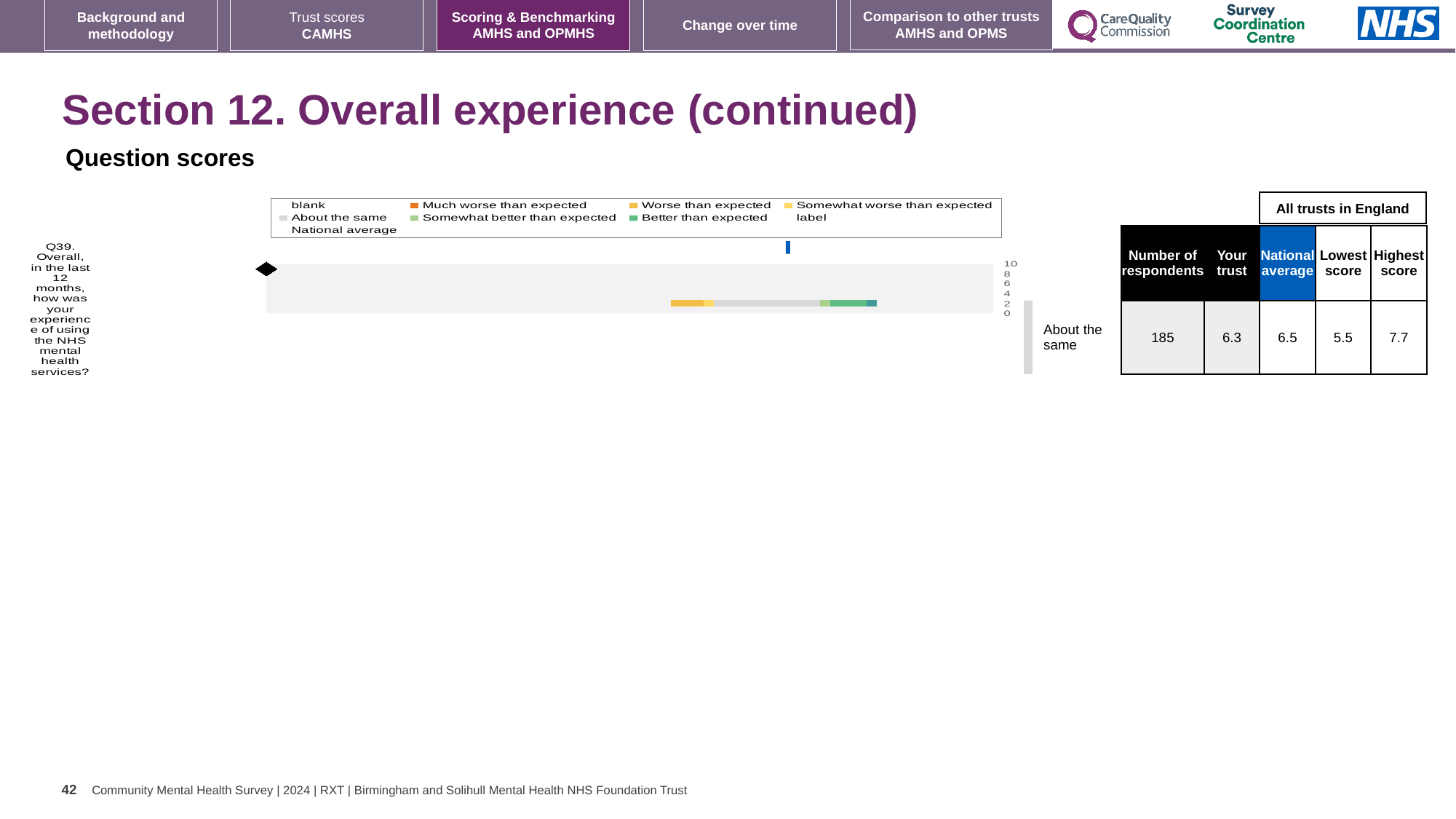
What is the difference between the highest score and the lowest score for Q39? 2.2 Which benchmark category is shown next to the chart for Q39? About the same What is the national average score for Q39 in the table beside the chart? 6.5 Which question number is plotted in the chart? Q39 How many entries does the chart legend list? 9 What is the 'Your trust' score for Q39 in the table beside the chart? 6.3 How many questions are plotted in the chart? 1 What is the lowest score among all trusts in England for Q39? 5.5 What kind of chart is shown on the slide? bar chart Which is larger for Q39, the 'Your trust' score or the national average? National average What is the highest score among all trusts in England for Q39? 7.7 How many respondents are listed for Q39 in the table beside the chart? 185